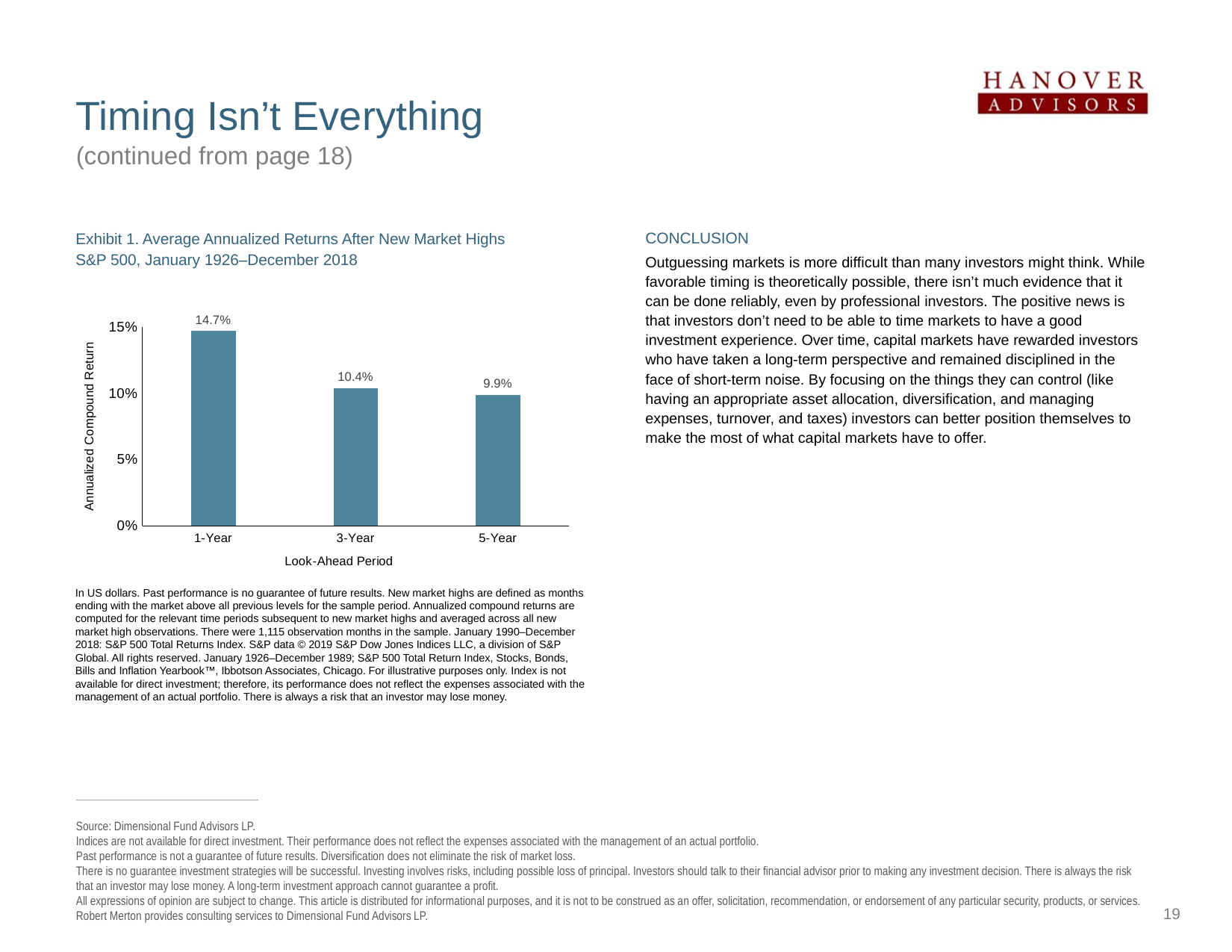
What is the annualized compound return for the 5-Year look-ahead period? 9.9% What is the annualized compound return for the 3-Year look-ahead period? 10.4% Which look-ahead period has the lowest annualized compound return? 5-Year How many look-ahead periods are shown in the chart? 3 Do the annualized compound returns rise or fall as the look-ahead period lengthens? Fall What is the difference between the 1-Year and 3-Year annualized compound returns? 4.3% What is the difference between the 3-Year and 5-Year annualized compound returns? 0.5% What kind of chart is shown on the slide? Bar chart Is the value for the 5-Year period greater or less than 10%? less Which is larger, the return for the 1-Year period or the 5-Year period? 1-Year What is the annualized compound return for the 1-Year look-ahead period? 14.7% Which look-ahead period has the highest annualized compound return? 1-Year